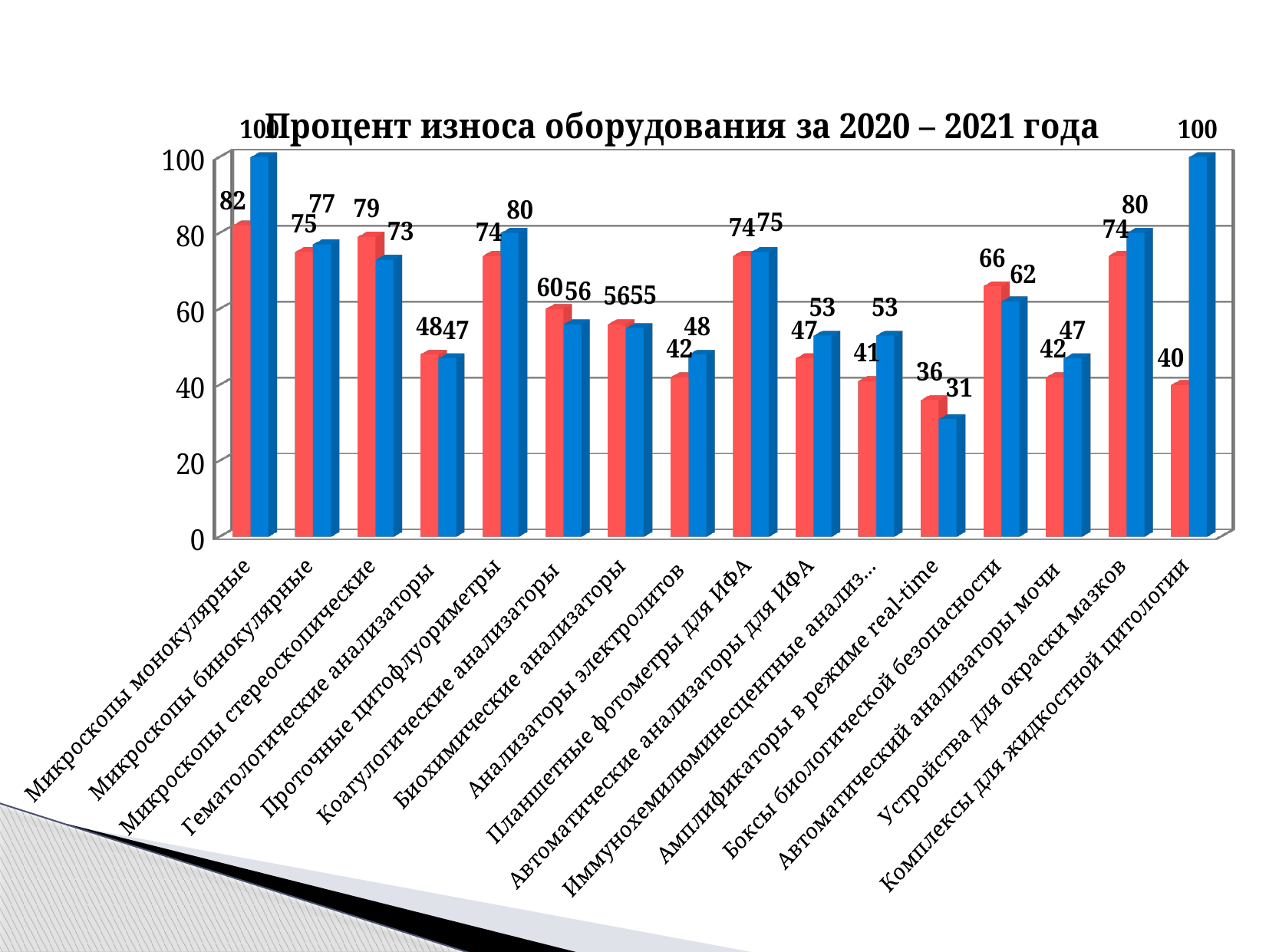
What type of chart is shown on the slide? bar chart For Микроскопы стереоскопические, which bar is larger, the red or the blue? red What is the value of the blue bar for Амплификаторы в режиме real-time? 31 How many equipment categories are shown on the x axis? 16 What is the title of the chart? Процент износа оборудования за 2020 – 2021 года What is the difference between the blue and red bars for Иммунохемилюминесцентные анализаторы? 12 What is the value of the red bar for Микроскопы монокулярные? 82 What is the value of the red bar for Боксы биологической безопасности? 66 Which category has the lowest blue bar? Амплификаторы в режиме real-time What is the value of the blue bar for Комплексы для жидкостной цитологии? 100 Which category has the highest red bar? Микроскопы монокулярные What is the difference between the blue and red bars for Комплексы для жидкостной цитологии? 60